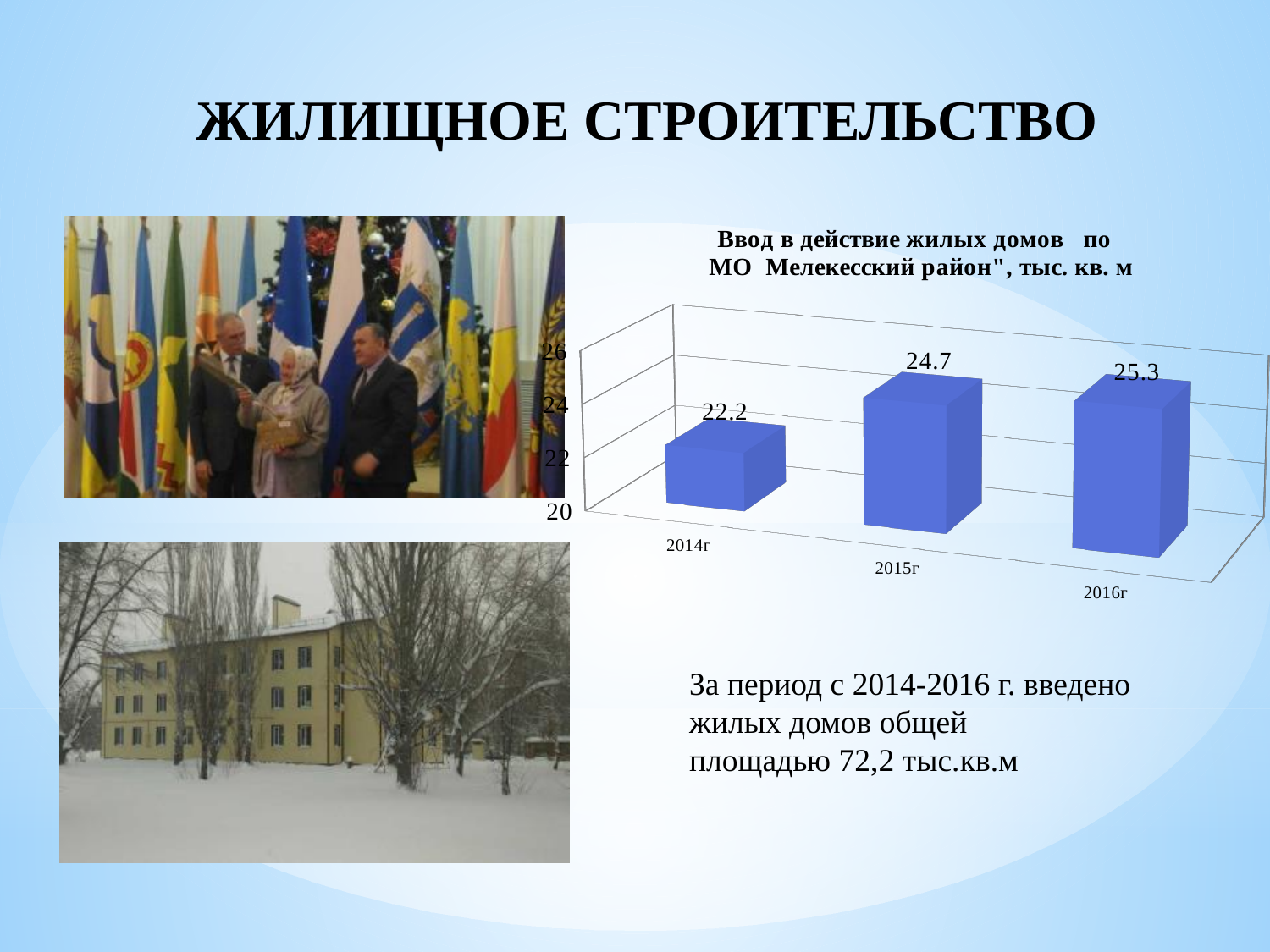
Which is larger, the value for 2015г or the value for 2014г? 2015г What is the difference between the values for 2016г and 2014г? 3.1 What is the difference between the values for 2015г and 2014г? 2.5 What is the value for 2016г? 25.3 Is the value for 2014г greater or less than 24? less Which year has the lowest value? 2014г Do the values rise or fall from 2014г to 2016г? rise How many years are shown on the chart? 3 What is the value for 2014г? 22.2 What kind of chart is shown on the slide? bar chart Which year has the highest value? 2016г What is the value for 2015г? 24.7